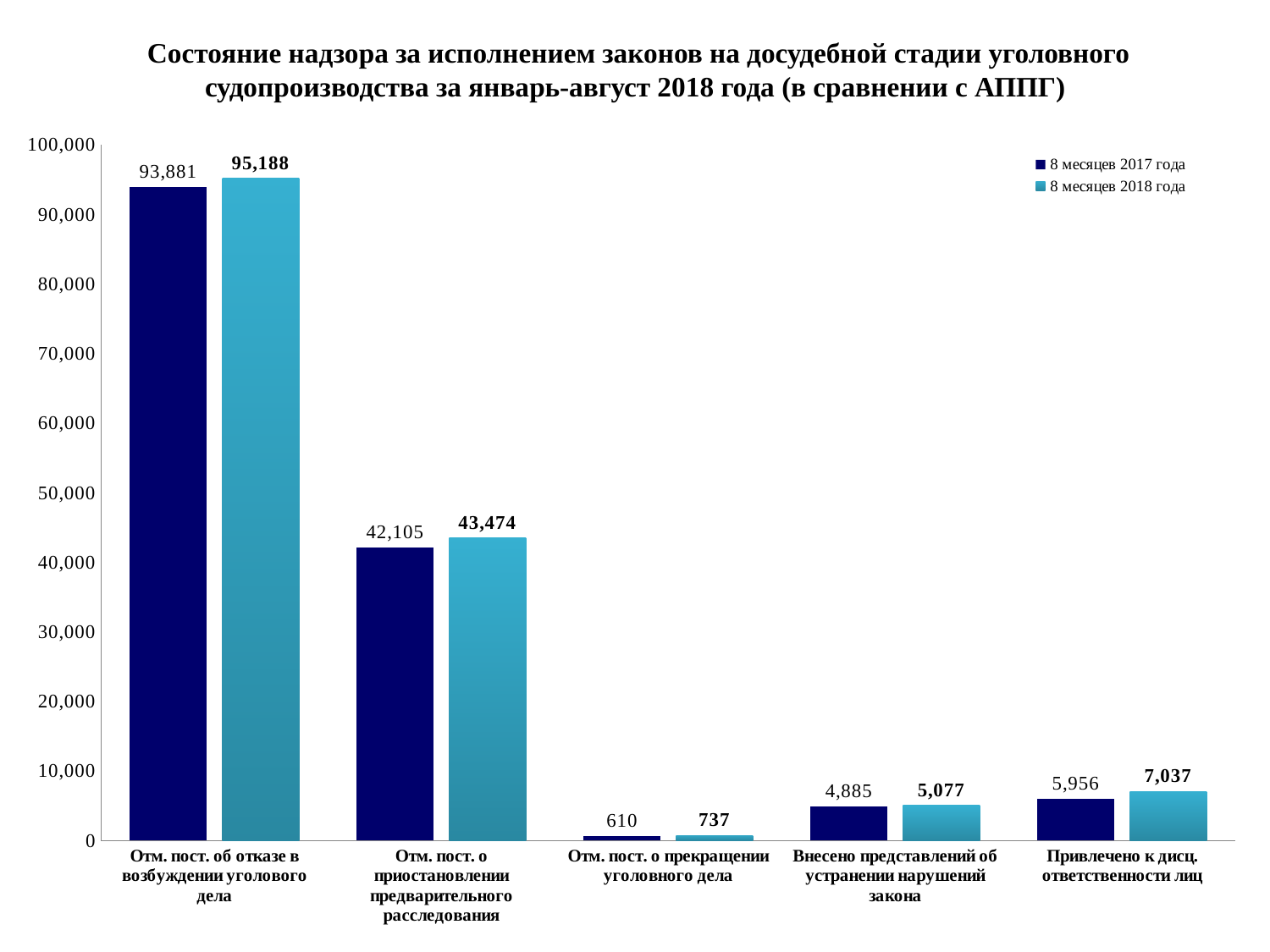
In the category "Отм. пост. о приостановлении предварительного расследования", which series has the larger value, "8 месяцев 2017 года" or "8 месяцев 2018 года"? 8 месяцев 2018 года Which category has the highest value for "8 месяцев 2018 года"? Отм. пост. об отказе в возбуждении уголового дела What is the value for "8 месяцев 2018 года" in the category "Отм. пост. об отказе в возбуждении уголового дела"? 95,188 What is the difference between the 2018 and 2017 values in the category "Привлечено к дисц. ответственности лиц"? 1,081 Which category has the lowest value for "8 месяцев 2017 года"? Отм. пост. о прекращении уголовного дела What is the difference between the 2018 and 2017 values in the category "Внесено представлений об устранении нарушений закона"? 192 How many series does the legend list? 2 What is the value for "8 месяцев 2017 года" in the category "Отм. пост. о прекращении уголовного дела"? 610 What kind of chart is shown on the slide? Bar chart How many categories are shown on the x axis? 5 What is the value for "8 месяцев 2017 года" in the category "Отм. пост. о приостановлении предварительного расследования"? 42,105 What is the value for "8 месяцев 2018 года" in the category "Привлечено к дисц. ответственности лиц"? 7,037